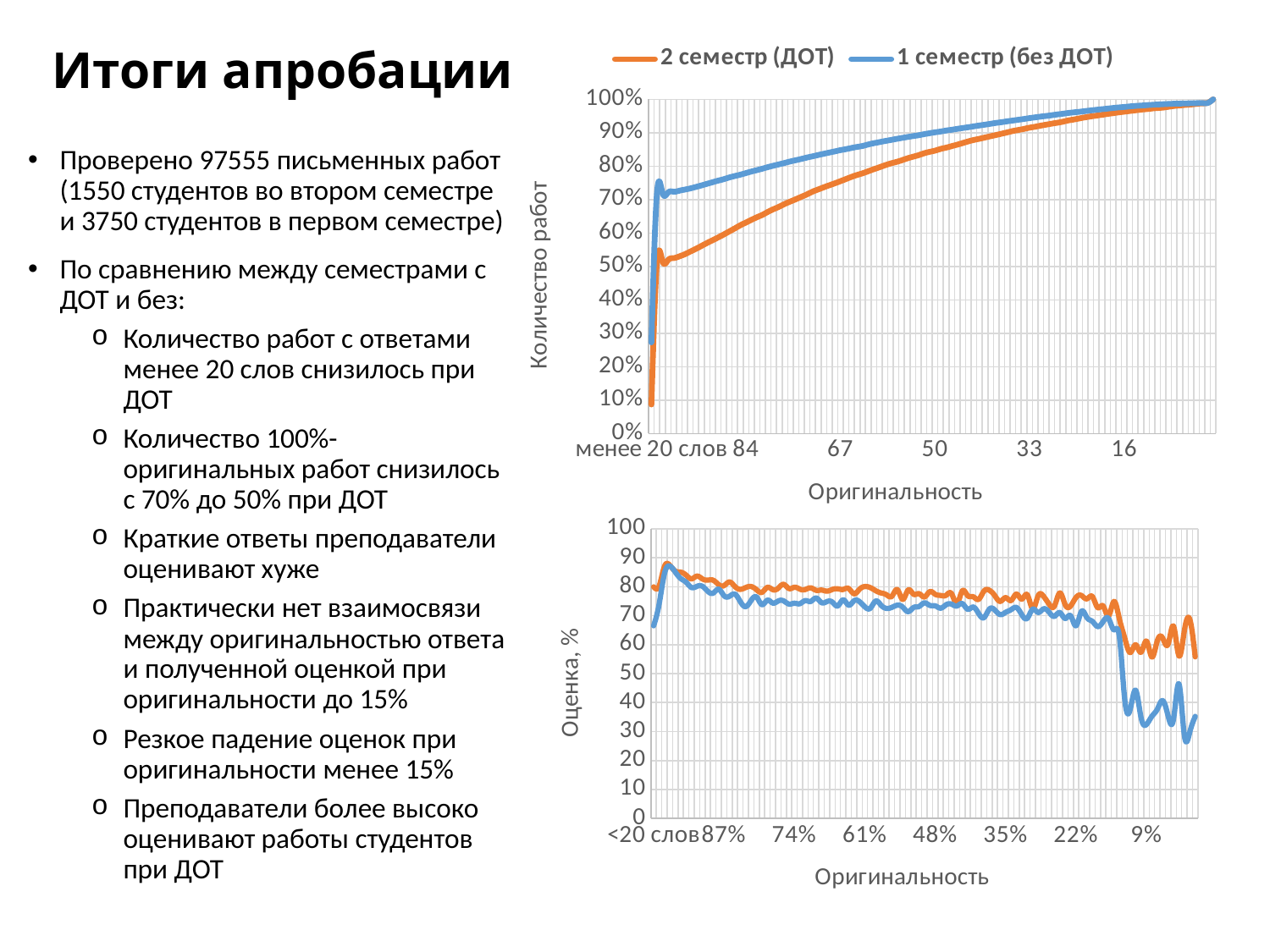
In the top chart, is the value of '1 семестр (без ДОТ)' at the x-axis value 50 greater or less than 80%? greater In the bottom chart, which line is higher at the x-axis value 48%: the orange line or the blue line? the orange line What are the two series named in the legend of the top chart? 2 семестр (ДОТ) and 1 семестр (без ДОТ) In the bottom chart, is the value of the orange line at the x-axis value 87% greater or less than 70? greater In the top chart, do the values of the '1 семестр (без ДОТ)' series rise or fall as you move from left to right along the x axis? rise What kind of chart is the top chart on the slide? line chart What is the y-axis title of the bottom chart? Оценка, % In the top chart, is the value of '2 семестр (ДОТ)' at the x-axis value 67 greater or less than 80%? less How many series does the legend of the top chart list? 2 What kind of chart is the bottom chart on the slide? line chart In the top chart, which series is higher at the x-axis value 67: '2 семестр (ДОТ)' or '1 семестр (без ДОТ)'? 1 семестр (без ДОТ)